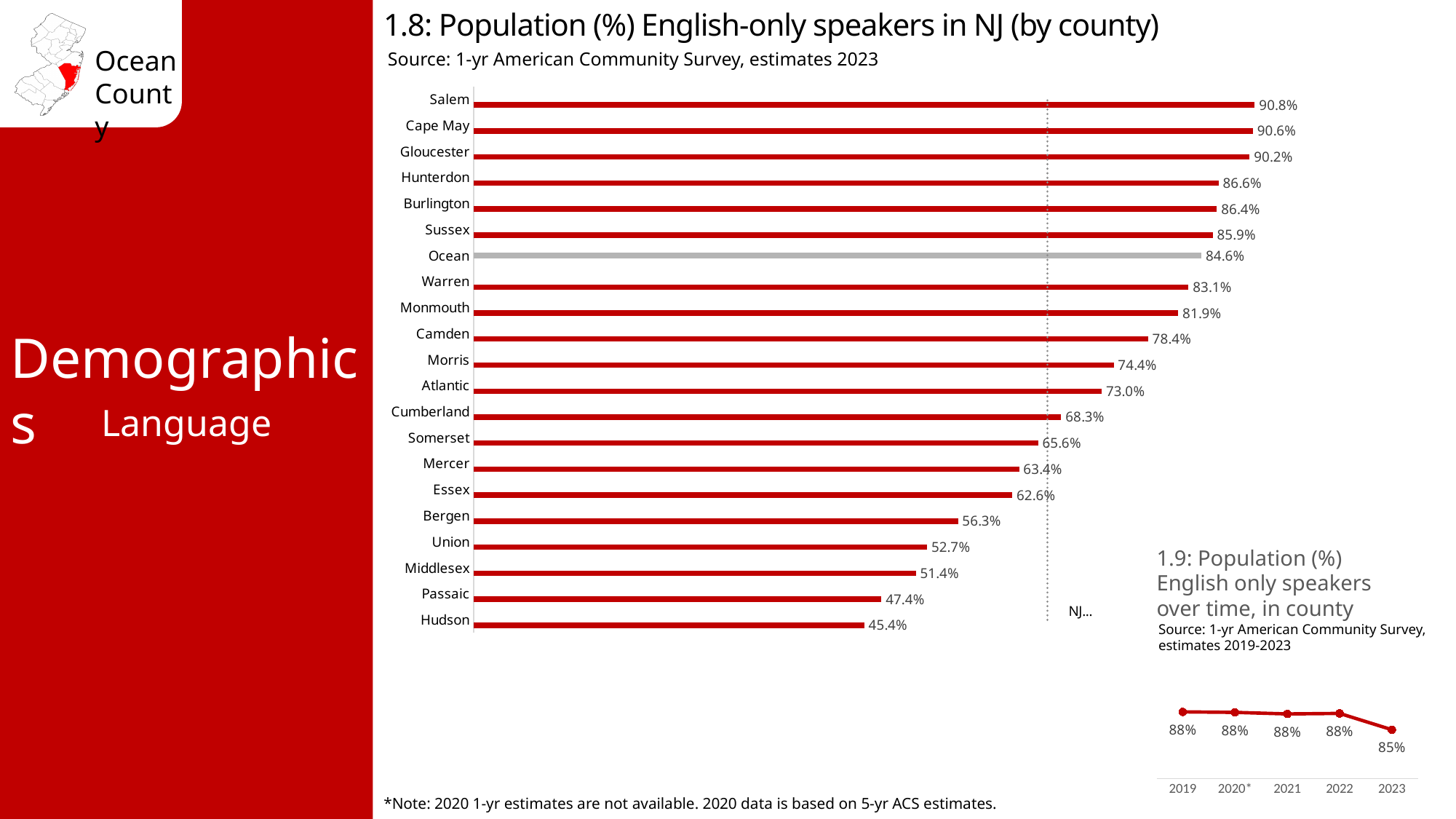
In chart 1.8, which county has the lowest percentage of English-only speakers? Hudson In chart 1.8, what is the percentage of English-only speakers in Passaic County? 47.4% In chart 1.8, which county has a higher percentage of English-only speakers, Monmouth or Camden? Monmouth In chart 1.9, do the values rise or fall from 2022 to 2023? Fall In chart 1.8, how many counties are shown? 21 In chart 1.8, what is the percentage of English-only speakers in Ocean County? 84.6% In chart 1.9, what is the percentage of English-only speakers in 2023? 85% In chart 1.8, which county has the highest percentage of English-only speakers? Salem In chart 1.9, how many years are plotted? 5 In chart 1.8, which county's bar is coloured grey instead of red? Ocean In chart 1.8, what is the difference between Salem's and Hudson's percentages? 45.4% What kind of chart is chart 1.8? Bar chart